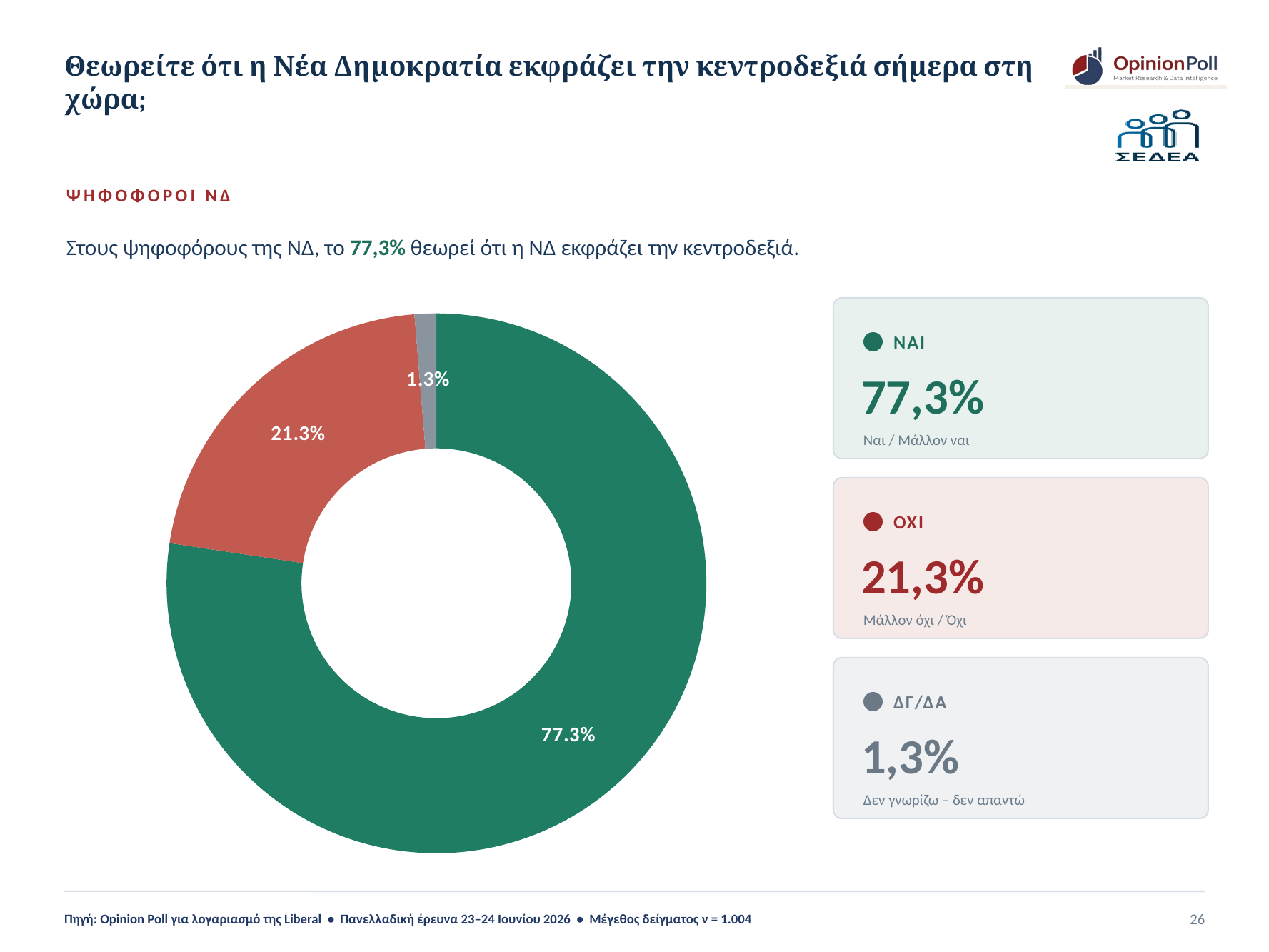
What kind of chart is shown on the slide? Donut (pie) chart What colour is the ΝΑΙ slice in the donut chart? Green What is the difference in percentage points between the ΝΑΙ and ΟΧΙ slices? 56 percentage points What share of ND voters answered ΔΓ/ΔΑ (don't know / no answer)? 1.3% Which response has the smallest slice of the donut chart? ΔΓ/ΔΑ Which is larger, the ΟΧΙ slice or the ΔΓ/ΔΑ slice? ΟΧΙ What share of ND voters answered ΝΑΙ (yes)? 77.3% What is the combined share of the ΟΧΙ and ΔΓ/ΔΑ slices? 22.6% How many slices does the donut chart have? 3 Which response has the largest slice of the donut chart? ΝΑΙ What share of ND voters answered ΟΧΙ (no)? 21.3% Which voter group does the chart refer to, according to the label above the chart? ΨΗΦΟΦΟΡΟΙ ΝΔ